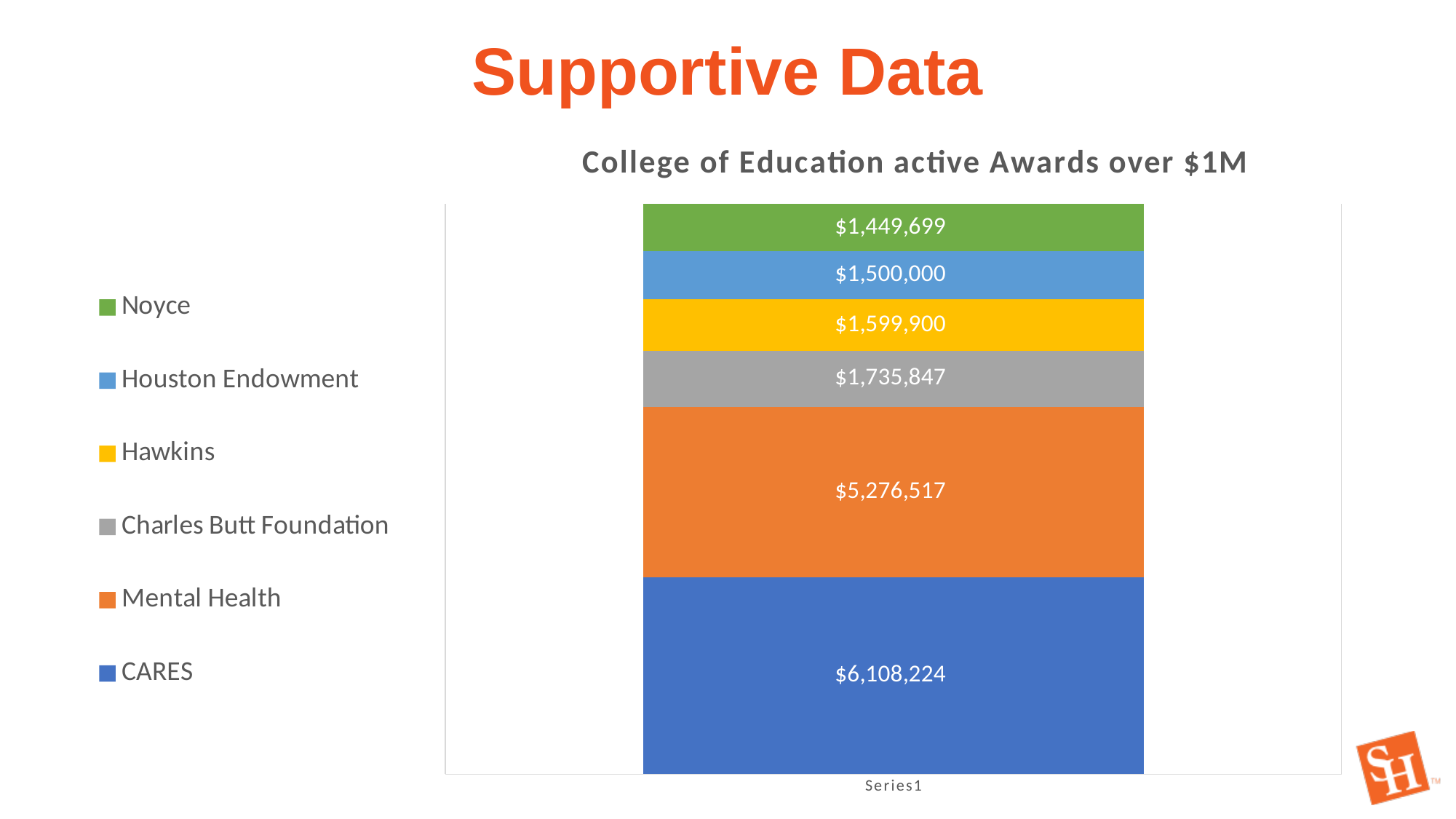
How many entries does the legend list? 6 Which is larger, the Houston Endowment value or the Hawkins value? Hawkins Which award has the largest value in the chart? CARES What is the value of the Mental Health segment? $5,276,517 What is the value shown for Noyce? $1,449,699 What is the total of all segments in the stacked bar? $17,670,187 What is the value shown for Hawkins? $1,599,900 Which award has the smallest value in the chart? Noyce What is the value shown for Charles Butt Foundation? $1,735,847 What type of chart is shown on the slide? Stacked bar chart What is the value of the CARES segment in the chart? $6,108,224 What is the difference between the CARES and Mental Health values? $831,707